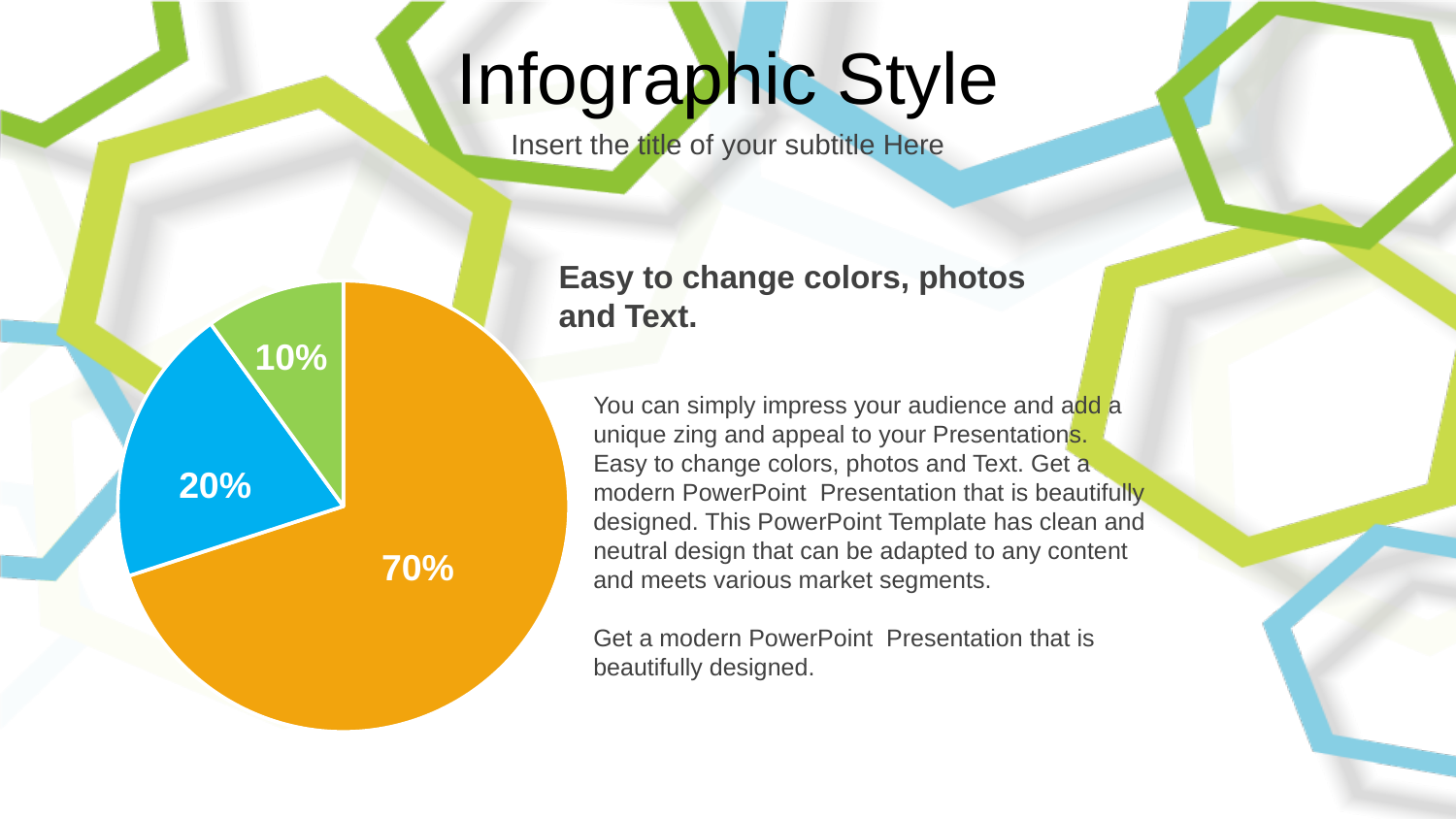
How many slices does the pie chart have? 3 What share of the pie does the orange slice represent? 70% Which slice of the pie chart is the largest? the orange slice (70%) What is the difference between the orange slice and the blue slice in the pie chart? 50% What value is labelled on the blue slice of the pie chart? 20% What is the difference between the blue slice and the green slice in the pie chart? 10% What value is labelled on the green slice of the pie chart? 10% Does the pie chart have a legend? No What value is labelled on the orange slice of the pie chart? 70% What kind of chart is shown on the slide? pie chart Which slice of the pie chart is the smallest? the green slice (10%) Which is larger in the pie chart, the blue slice or the green slice? the blue slice